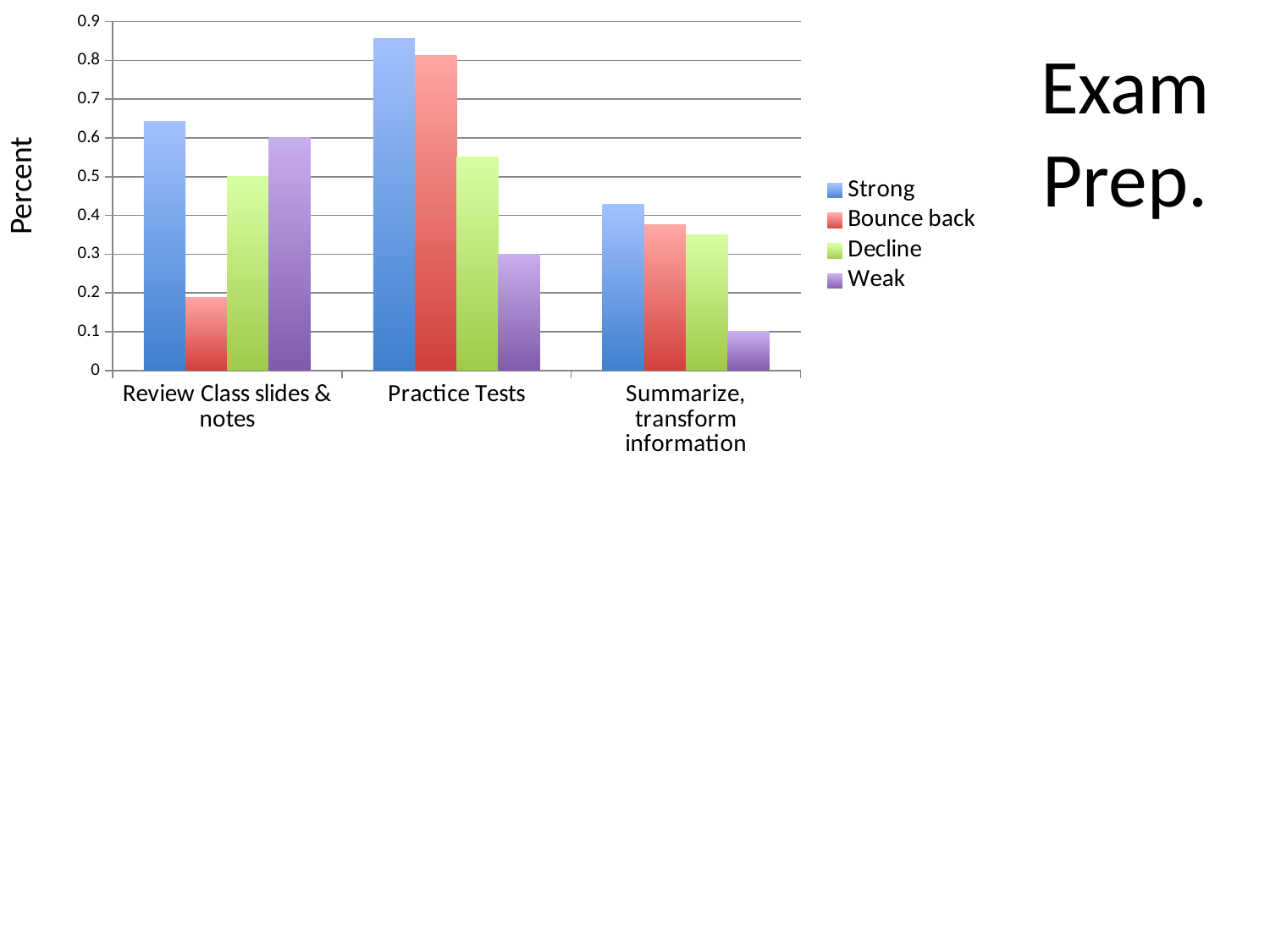
In which category is the Weak bar the lowest? Summarize, transform information What colour represents the Decline series in the legend? green How many categories are shown on the x axis? 3 In which category is the Strong bar the highest? Practice Tests What is the label on the vertical axis? Percent What kind of chart is shown on the slide? bar chart Which series has the lowest bar in the Summarize, transform information category? Weak In Review Class slides & notes, which is larger: Strong or Bounce back? Strong In Practice Tests, which is larger: Decline or Weak? Decline How many series does the legend list? 4 Is the value for Strong in Practice Tests greater or less than 0.8? greater